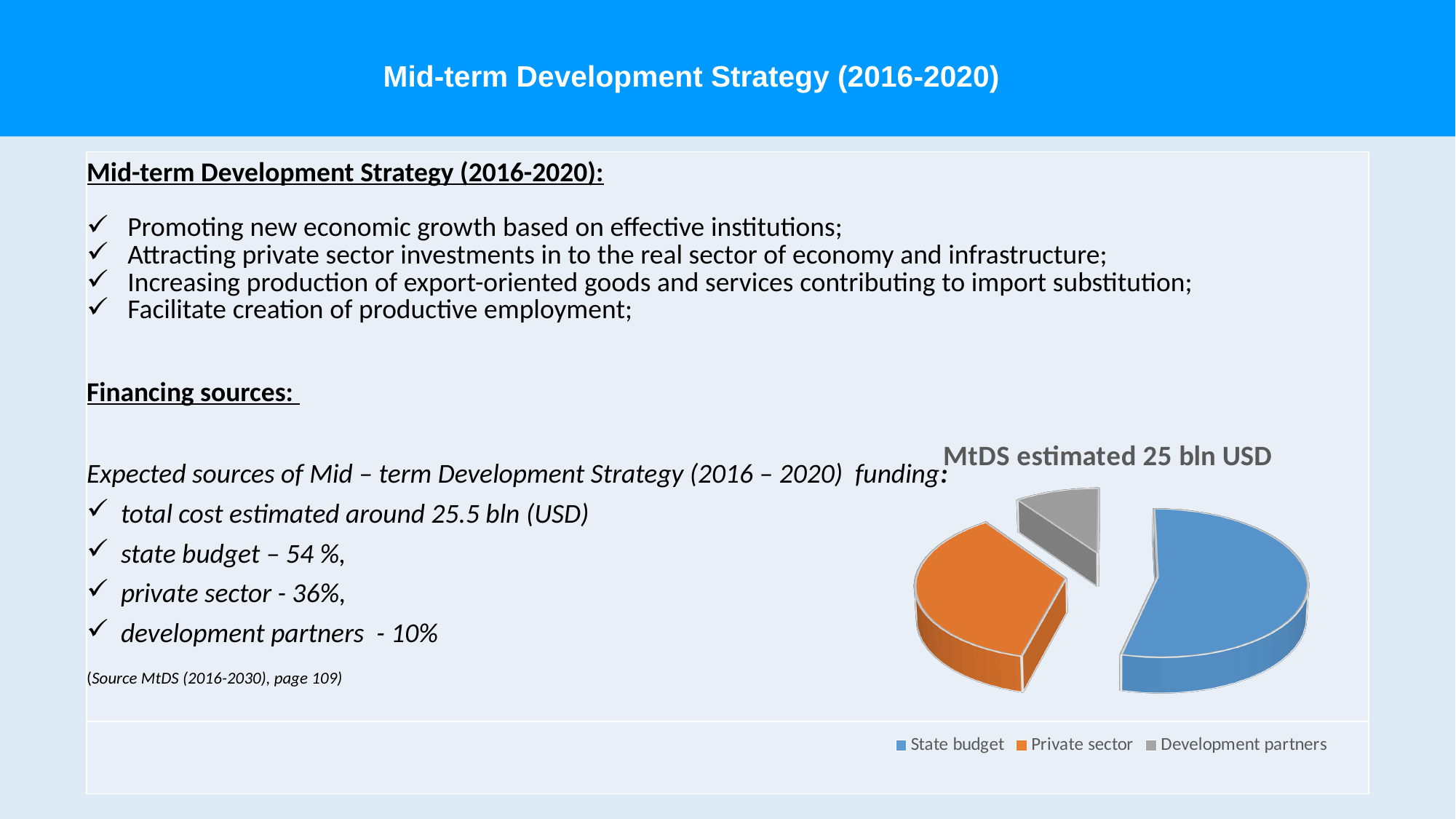
What colour is the State budget slice in the pie chart? blue How many slices does the pie chart have? 3 Which financing source has the smallest slice of the pie chart? Development partners What kind of chart is shown on the slide? pie chart Which financing source has the largest slice of the pie chart? State budget According to the slide, what share of the funding comes from the state budget? 54 % Which slice is larger in the pie chart, State budget or Private sector? State budget How many entries does the pie chart's legend list? 3 What is the title of the pie chart? MtDS estimated 25 bln USD According to the slide, what share of the funding comes from development partners? 10% Which slice is larger in the pie chart, Private sector or Development partners? Private sector According to the slide, what share of the funding comes from the private sector? 36%